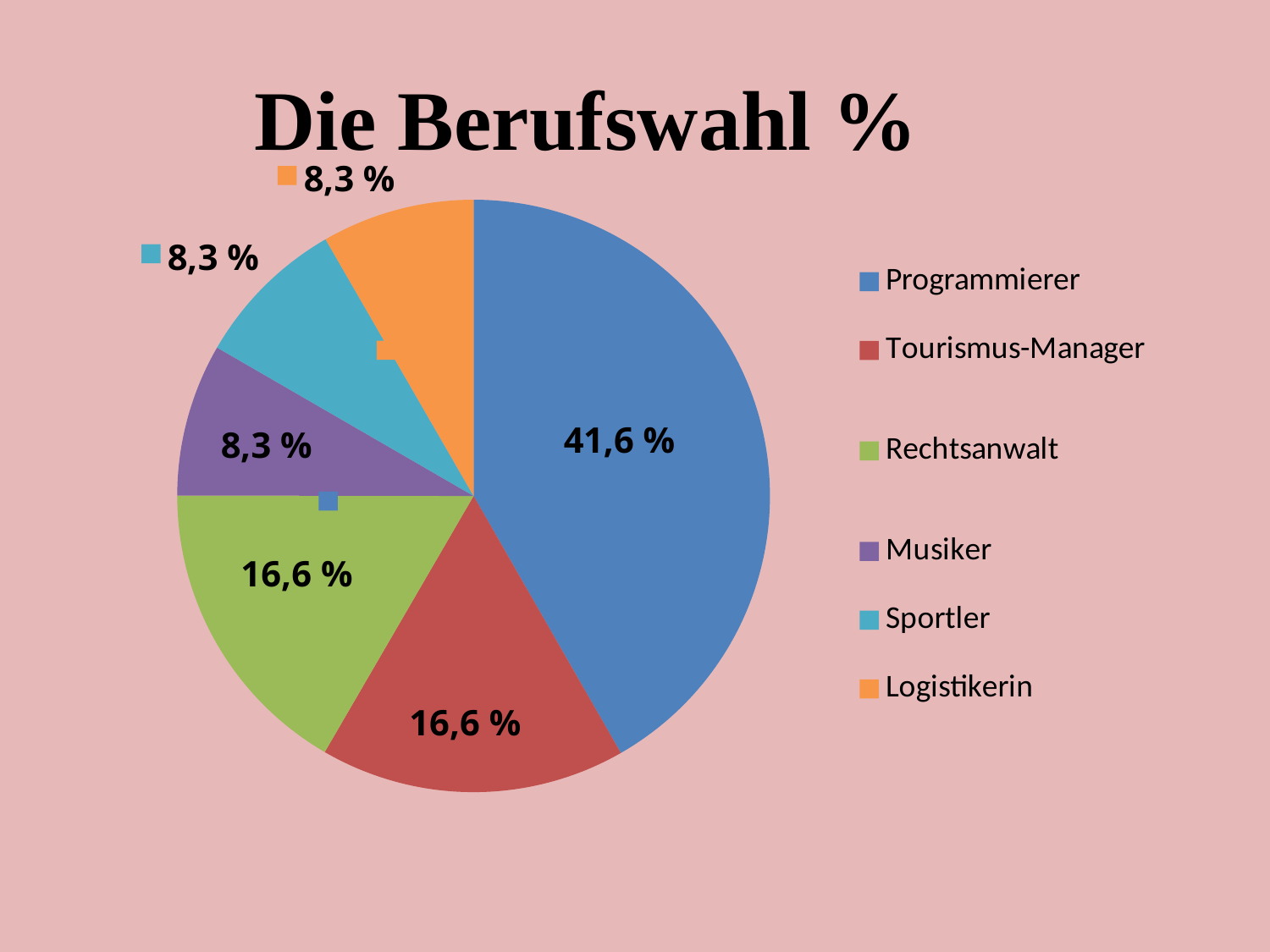
What is the difference between the Programmierer share and the Rechtsanwalt share? 25 % How many slices does the pie chart have? 6 What is the difference between the Rechtsanwalt share and the Sportler share? 8,3 % Which profession has the largest slice of the pie? Programmierer What percentage is shown for Tourismus-Manager? 16,6 % Which colour represents Sportler in the legend? light blue What percentage is shown for Logistikerin? 8,3 % What type of chart is shown on the slide? pie chart Which is larger, the slice for Programmierer or the slice for Rechtsanwalt? Programmierer What percentage is shown for Musiker? 8,3 % What is the title of the chart? Die Berufswahl % What percentage is shown for Programmierer? 41,6 %